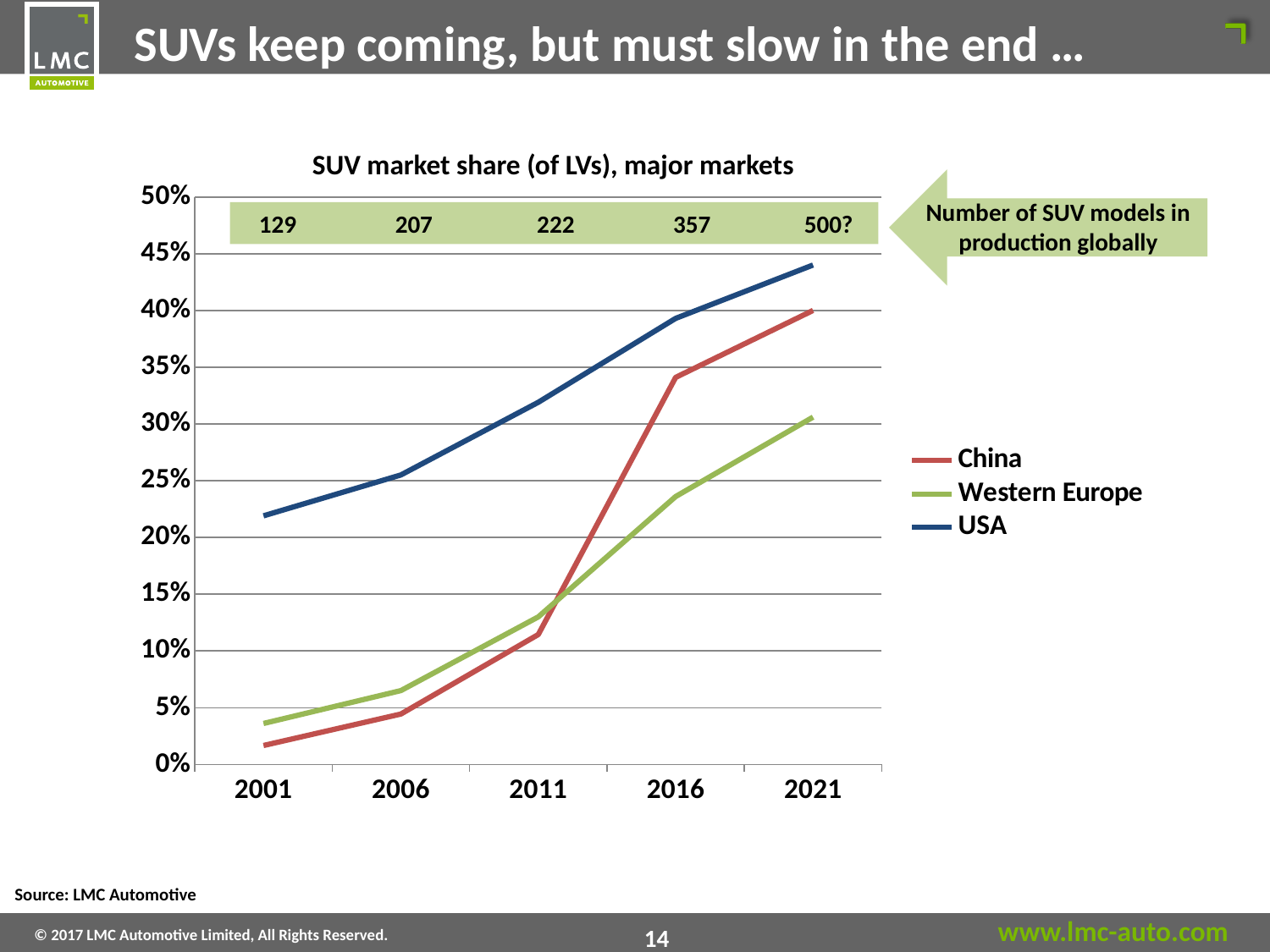
Which series has the lowest SUV market share in 2001? China How many series does the legend list? 3 How many years are shown on the x axis? 5 Does the USA line rise or fall from 2001 to 2021? rise What is the title of the chart? SUV market share (of LVs), major markets Which series has the highest SUV market share in 2021? USA In 2016, which has the larger SUV market share, China or Western Europe? China Is the value for Western Europe in 2021 greater or less than 35%? less Is the value for China in 2016 greater or less than 30%? greater Is the value for USA in 2021 greater or less than 40%? greater What kind of chart is shown on the slide? line chart